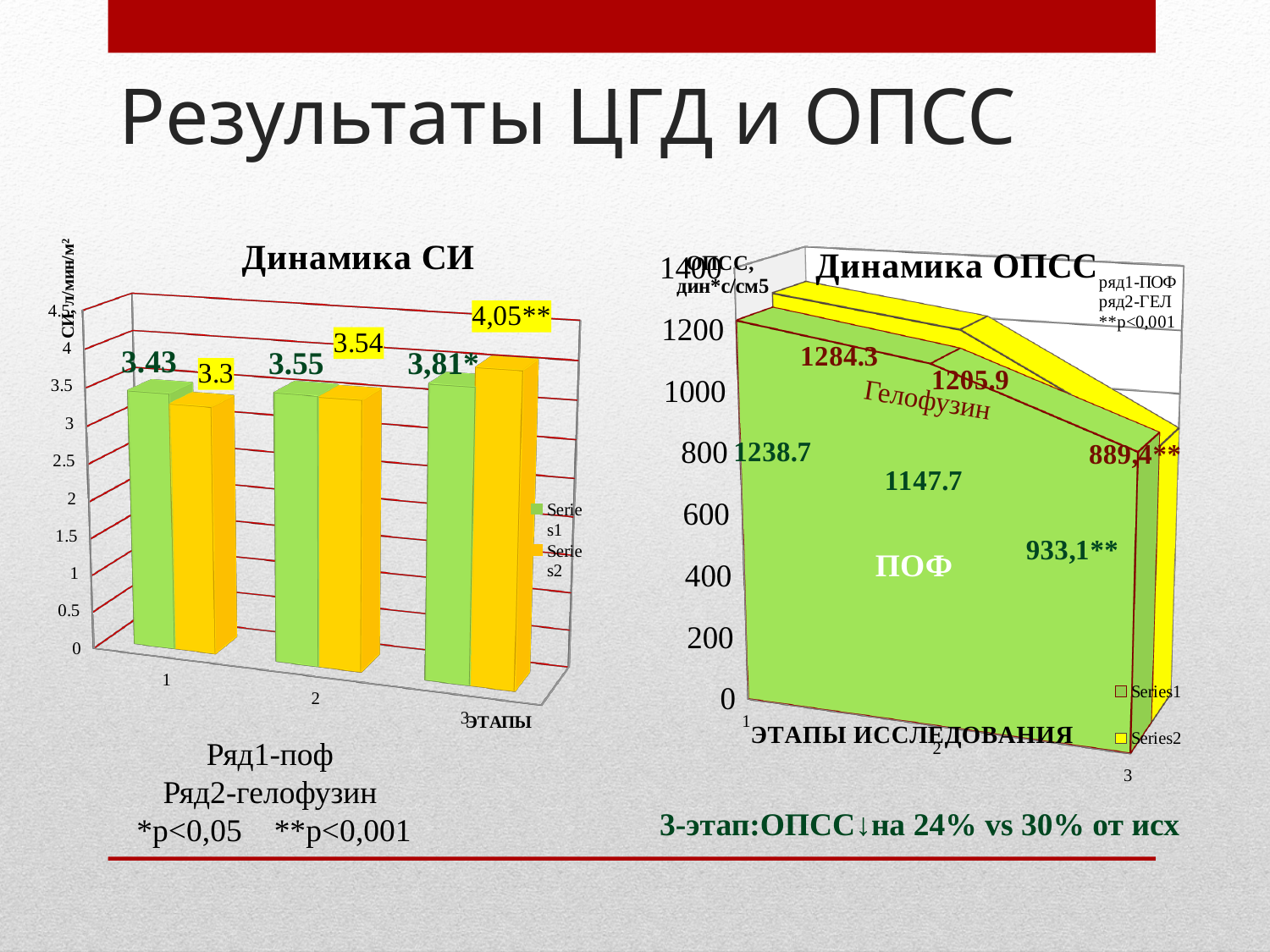
What kind of chart is the 'Динамика СИ' chart on the left? bar chart In the 'Динамика СИ' chart, what is the value of Series1 at stage 1? 3.43 In the 'Динамика СИ' chart, how many series does the legend list? 2 In the 'Динамика ОПСС' chart, what is the value for Гелофузин at stage 1? 1284.3 In the 'Динамика СИ' chart, how many stages (categories) are shown on the x axis? 3 In the 'Динамика ОПСС' chart, do the ПОФ values rise or fall from stage 1 to stage 3? fall In the 'Динамика СИ' chart, do the Series1 values rise or fall from stage 1 to stage 3? rise What is the title of the chart on the right side of the slide? Динамика ОПСС In the 'Динамика ОПСС' chart, what is the value for ПОФ at stage 2? 1147.7 In the 'Динамика СИ' chart, what is the value of Series2 at stage 2? 3.54 In the 'Динамика СИ' chart, at stage 1, which series has the larger value, Series1 or Series2? Series1 In the 'Динамика ОПСС' chart, what is the difference between the Гелофузин and ПОФ values at stage 1? 45.6